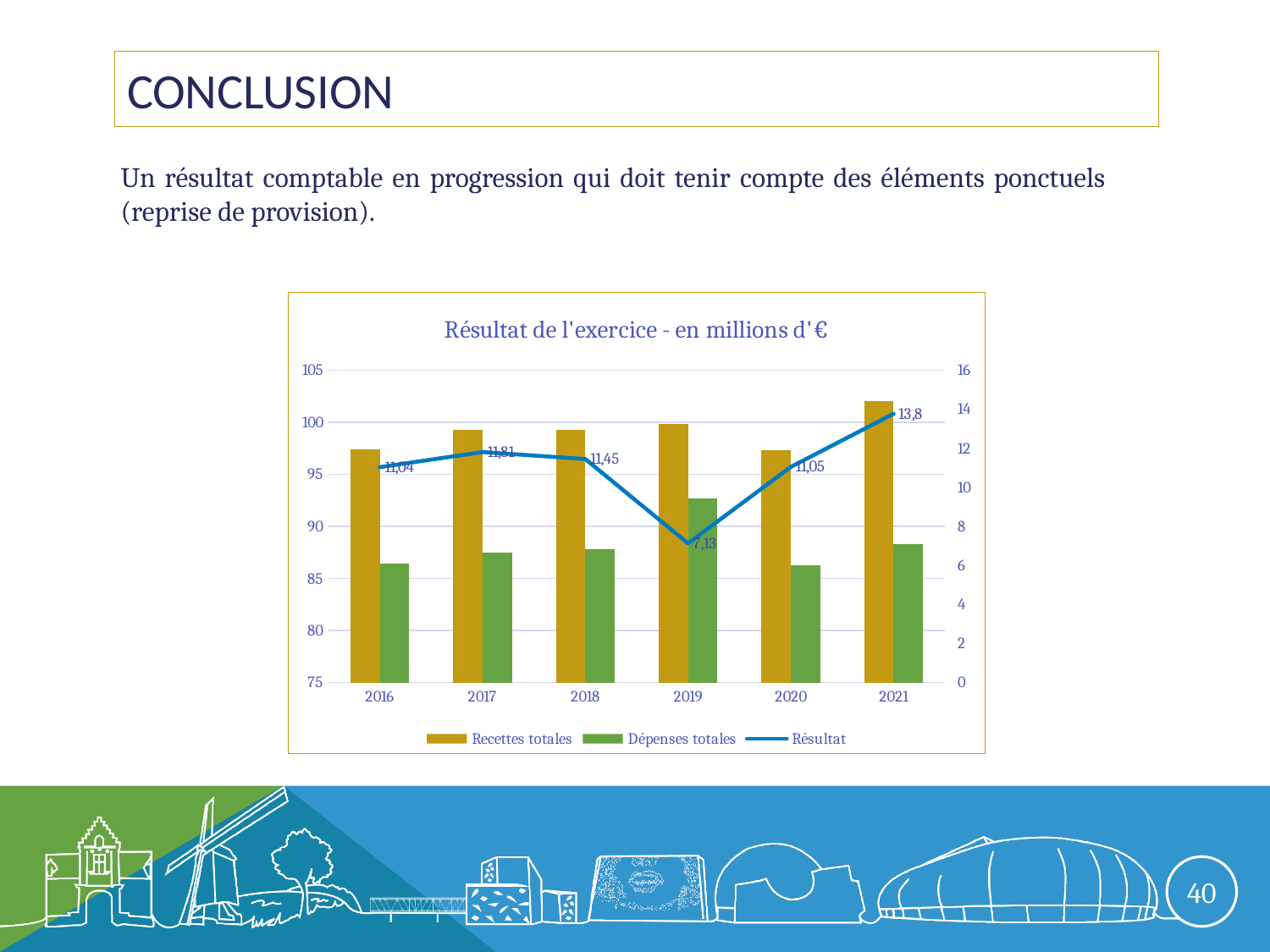
How many years are shown on the x axis? 6 Is the value of Recettes totales for 2021 greater or less than 100? greater Which is larger, the Résultat for 2017 or the Résultat for 2018? 2017 In which year is the Résultat lowest? 2019 In which year is the Résultat highest? 2021 What is the value of Résultat for 2016? 11,04 What is the value of Résultat for 2019? 7,13 What is the difference between the Résultat for 2021 and the Résultat for 2019? 6,67 Is the value of Dépenses totales for 2019 greater or less than 90? greater What is the value of Résultat for 2021? 13,8 What kind of chart is this? Combined bar and line chart How many series does the legend list? 3